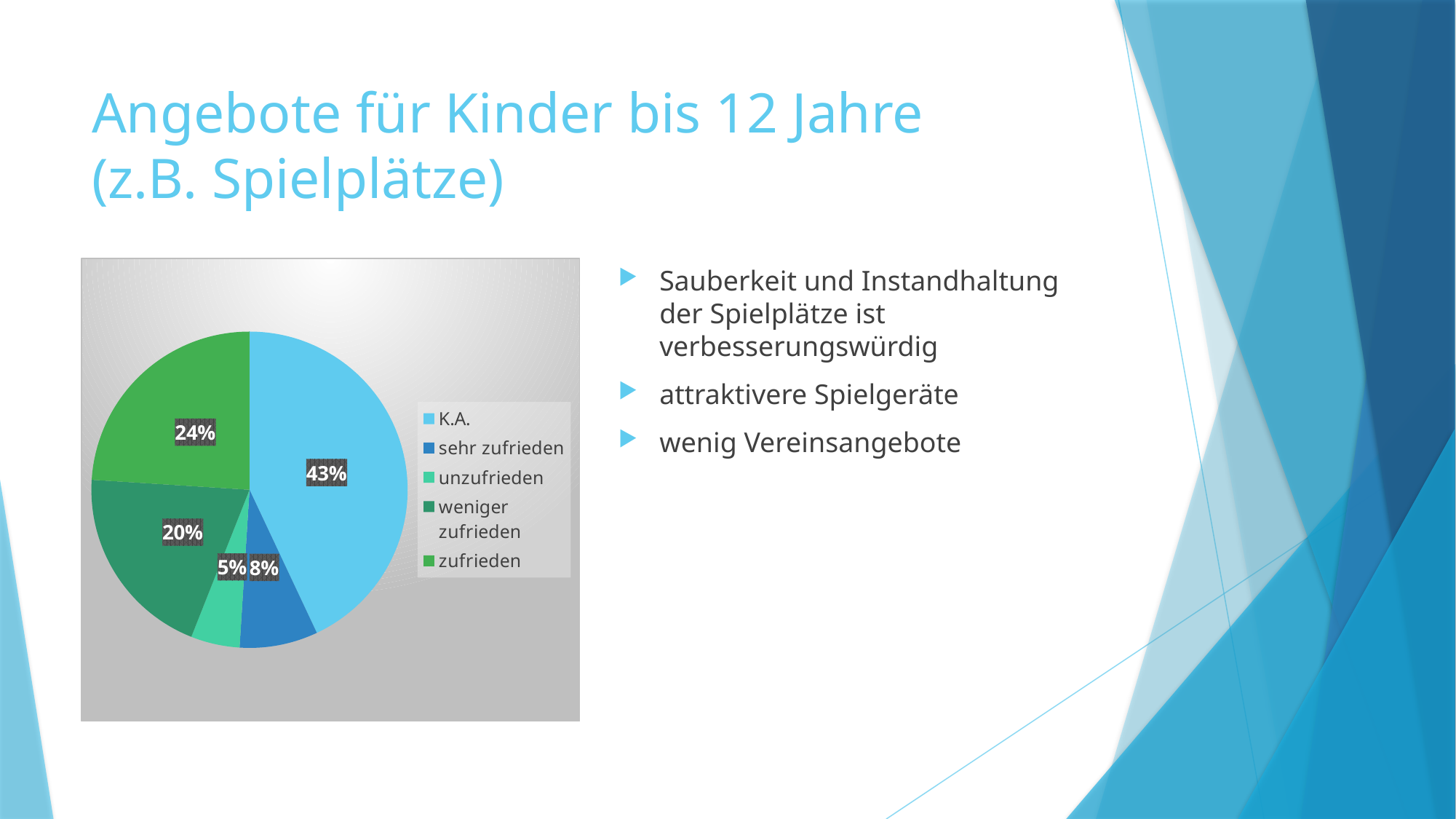
Which is larger, the share for "sehr zufrieden" or the share for "unzufrieden"? sehr zufrieden Which category has the smallest slice of the pie? unzufrieden Which legend entry is shown in light blue? K.A. What percentage is shown for "zufrieden"? 24% What is the difference in percentage points between "zufrieden" and "weniger zufrieden"? 4 What percentage is shown for "sehr zufrieden"? 8% What percentage is shown for "unzufrieden"? 5% Which category has the largest slice of the pie? K.A. What kind of chart is shown on the slide? pie chart How many categories does the pie chart have? 5 What percentage is shown for "weniger zufrieden"? 20% What share of the pie does the "K.A." slice represent? 43%